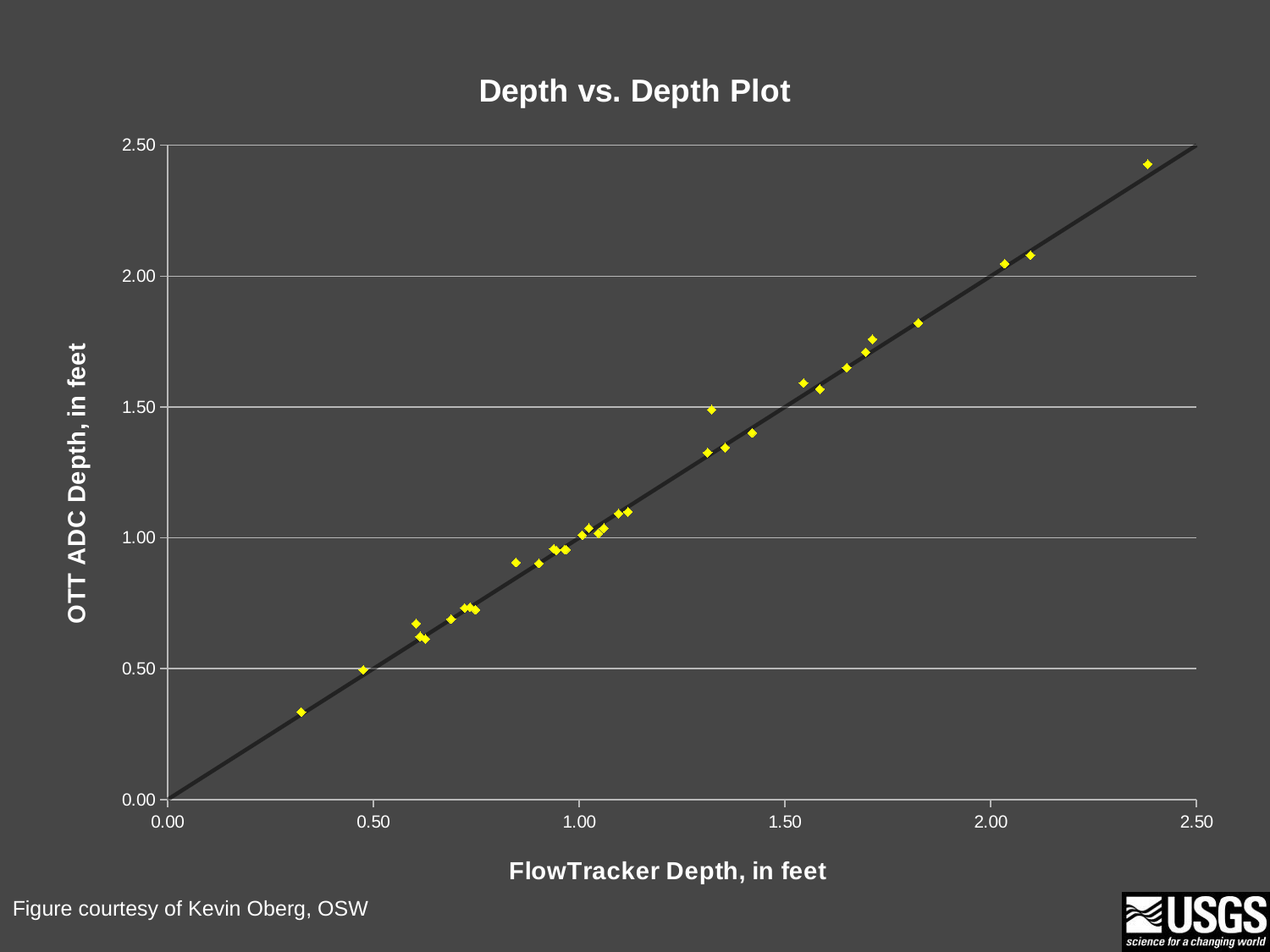
Which point has the higher OTT ADC depth: the one with the largest FlowTracker depth or the one with the smallest FlowTracker depth? the one with the largest FlowTracker depth Do the OTT ADC depth values generally rise or fall as FlowTracker depth increases along the x axis? rise Is the OTT ADC depth of the point with the smallest FlowTracker depth greater or less than 0.50? less What kind of chart is shown on the slide? scatter plot What is the title of the chart? Depth vs. Depth Plot Is the OTT ADC depth of the point with the largest FlowTracker depth greater or less than 2.50? less Is the FlowTracker depth of the lowest plotted point greater or less than 0.50? less What is the label of the horizontal axis? FlowTracker Depth, in feet